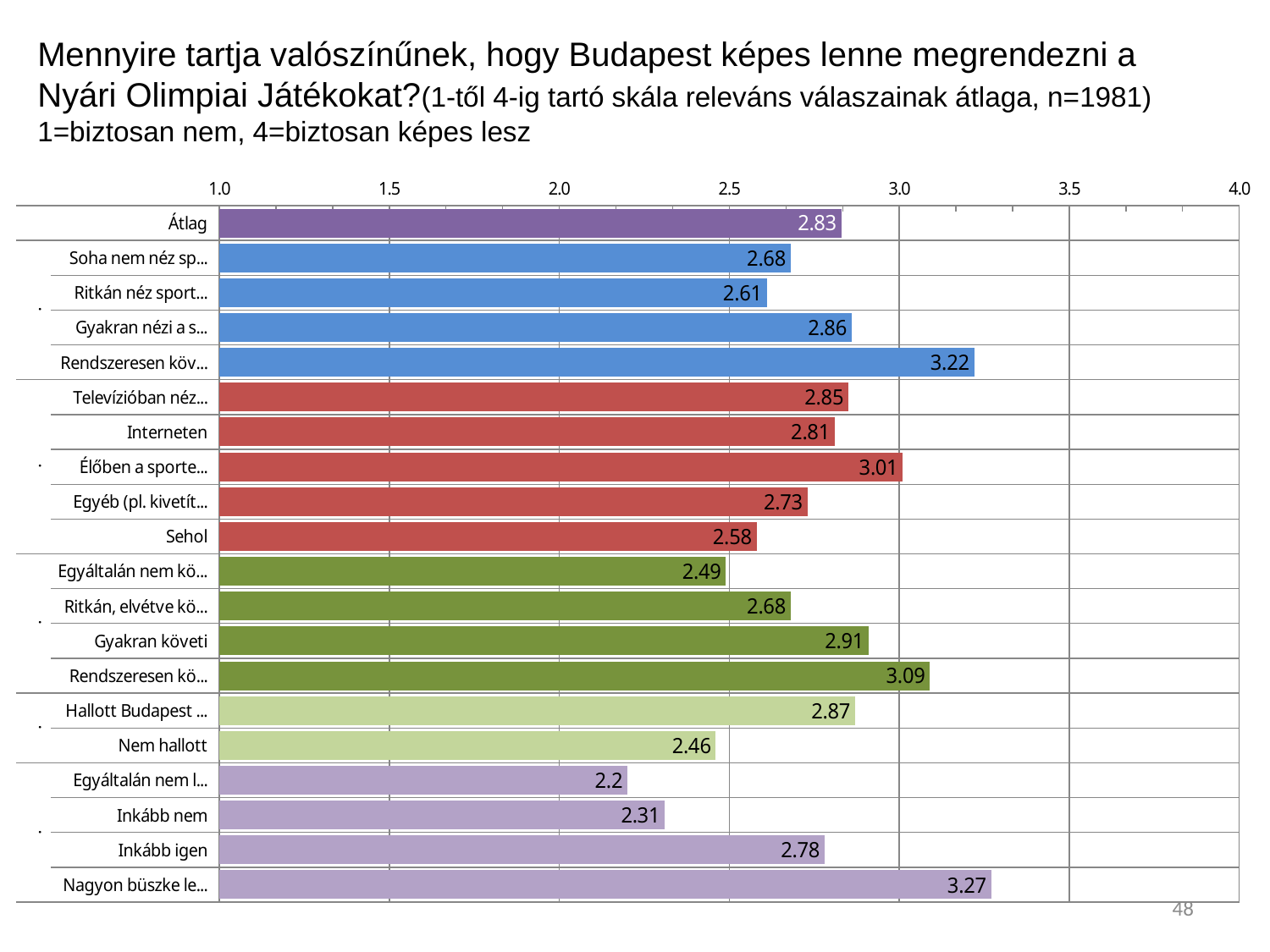
What is the value for Gyakran követi? 2.91 What is the value for Nem hallott? 2.46 What is the lowest value shown on the chart? 2.2 What is the value for Átlag? 2.83 What is the value for Interneten? 2.81 What is the highest value shown on the chart? 3.27 How many bars are shown on the chart? 20 Is the value for Nem hallott greater or less than 2.5? less What is the value for Sehol? 2.58 Which has a larger value, Interneten or Sehol? Interneten What is the difference between the values for Inkább igen and Inkább nem? 0.47 What kind of chart is shown on the slide? bar chart